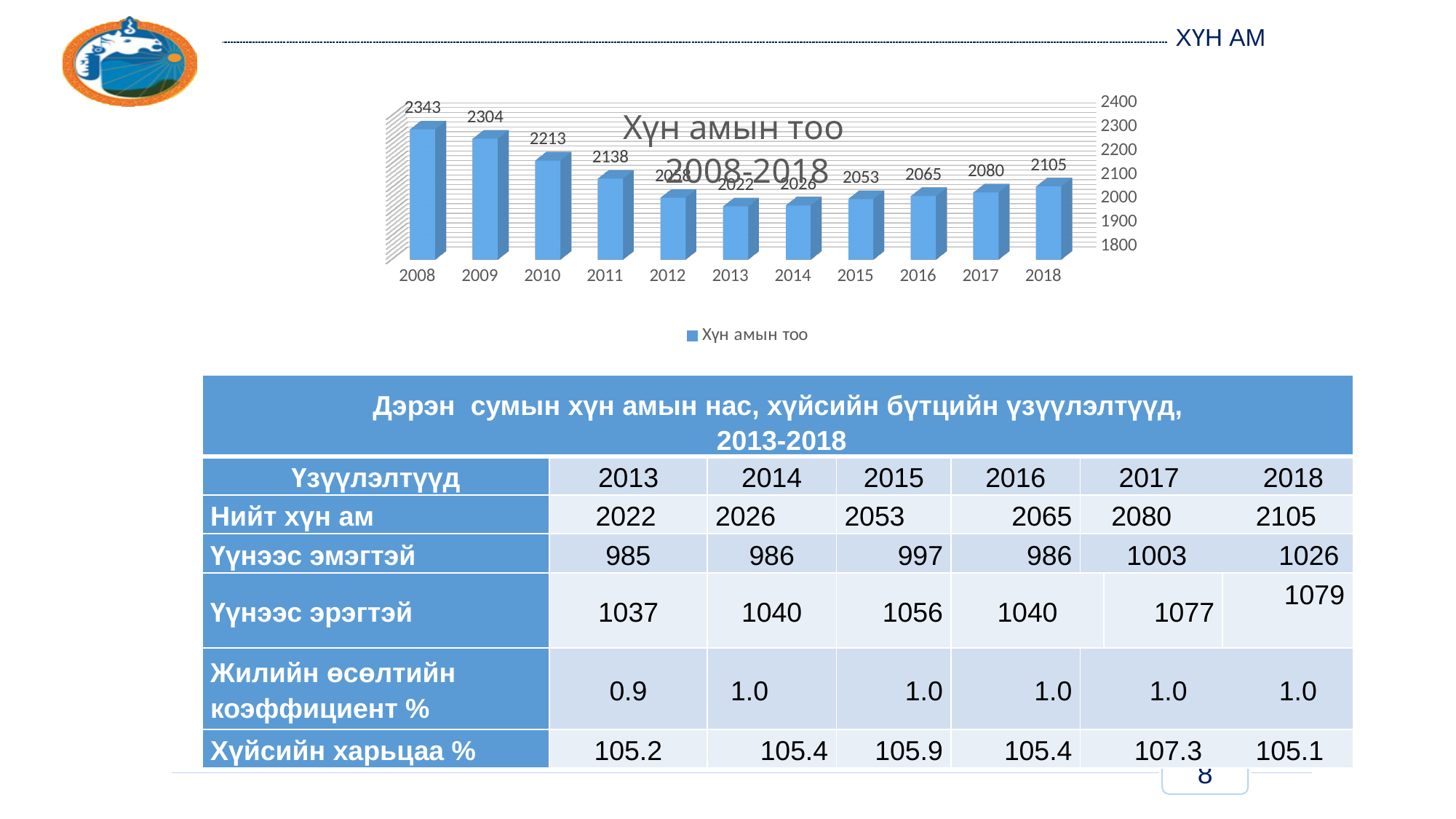
How many series does the chart legend list? 1 Do the values rise or fall from 2013 to 2018? rise What is the difference between the values for 2008 and 2018? 238 Which year has the lowest value in the chart? 2013 How many years are shown on the x axis of the chart? 11 Is the value for 2012 greater or less than 2100? less What is the value for 2008 in the chart? 2343 Which is larger, the value for 2009 or the value for 2010? 2009 What is the value for 2013 in the chart? 2022 What kind of chart is shown on the slide? bar chart What is the value for 2018 in the chart? 2105 Which year has the highest value in the chart? 2008